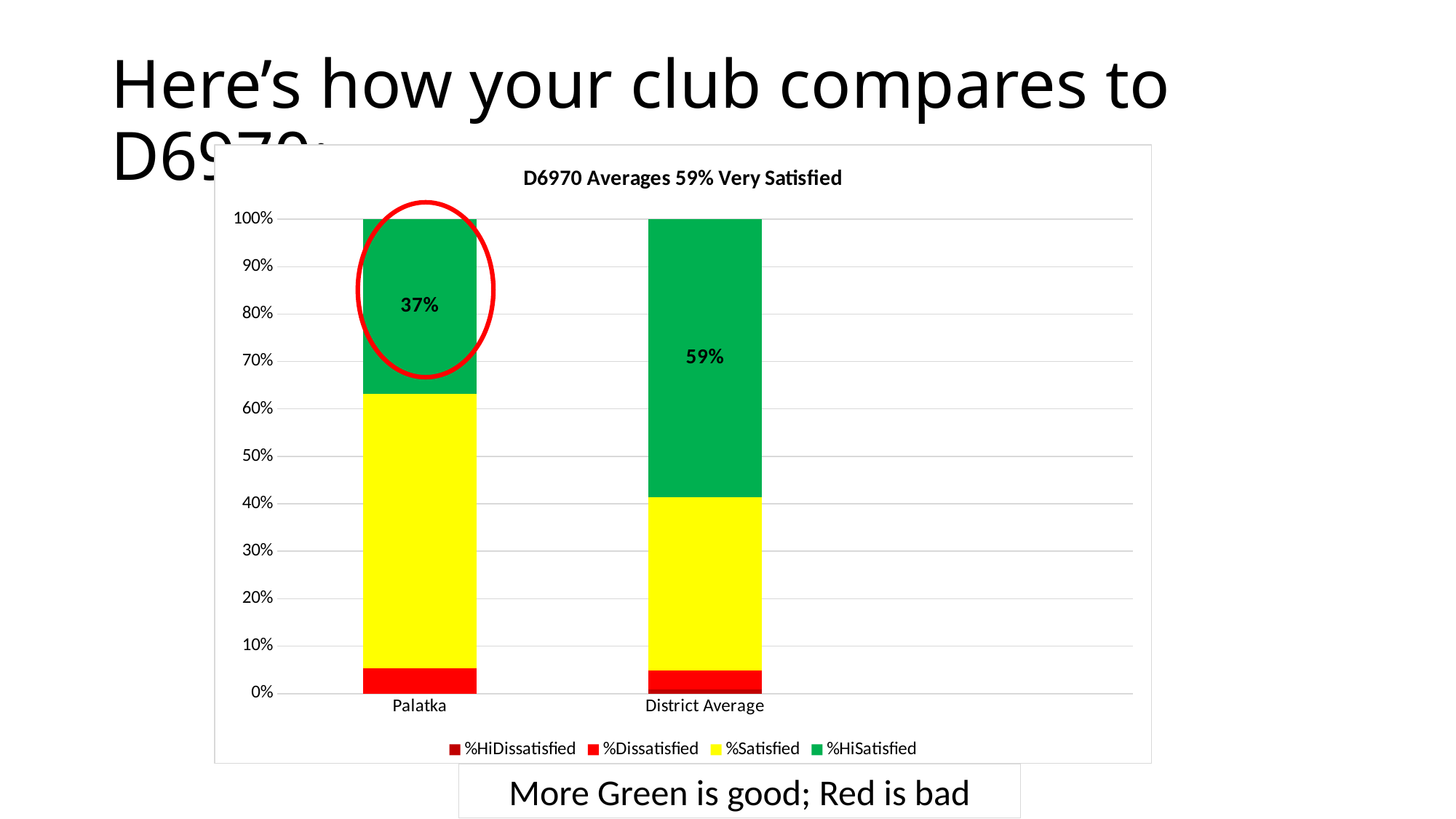
What is the %HiSatisfied value for Palatka? 37% What colour represents %HiSatisfied in the legend? Green What kind of chart is shown on the slide? Stacked bar chart Which series makes up the largest segment of the Palatka bar? %Satisfied How many categories are shown on the x axis? 2 What is the %HiSatisfied value for District Average? 59% Is the %Satisfied segment for Palatka greater or less than 50%? greater What is the title of the chart? D6970 Averages 59% Very Satisfied Which has the larger %HiSatisfied share, Palatka or District Average? District Average By how many percentage points does the District Average %HiSatisfied exceed Palatka's? 22 percentage points Is the %Satisfied segment for District Average greater or less than 50%? less How many series does the legend list? 4